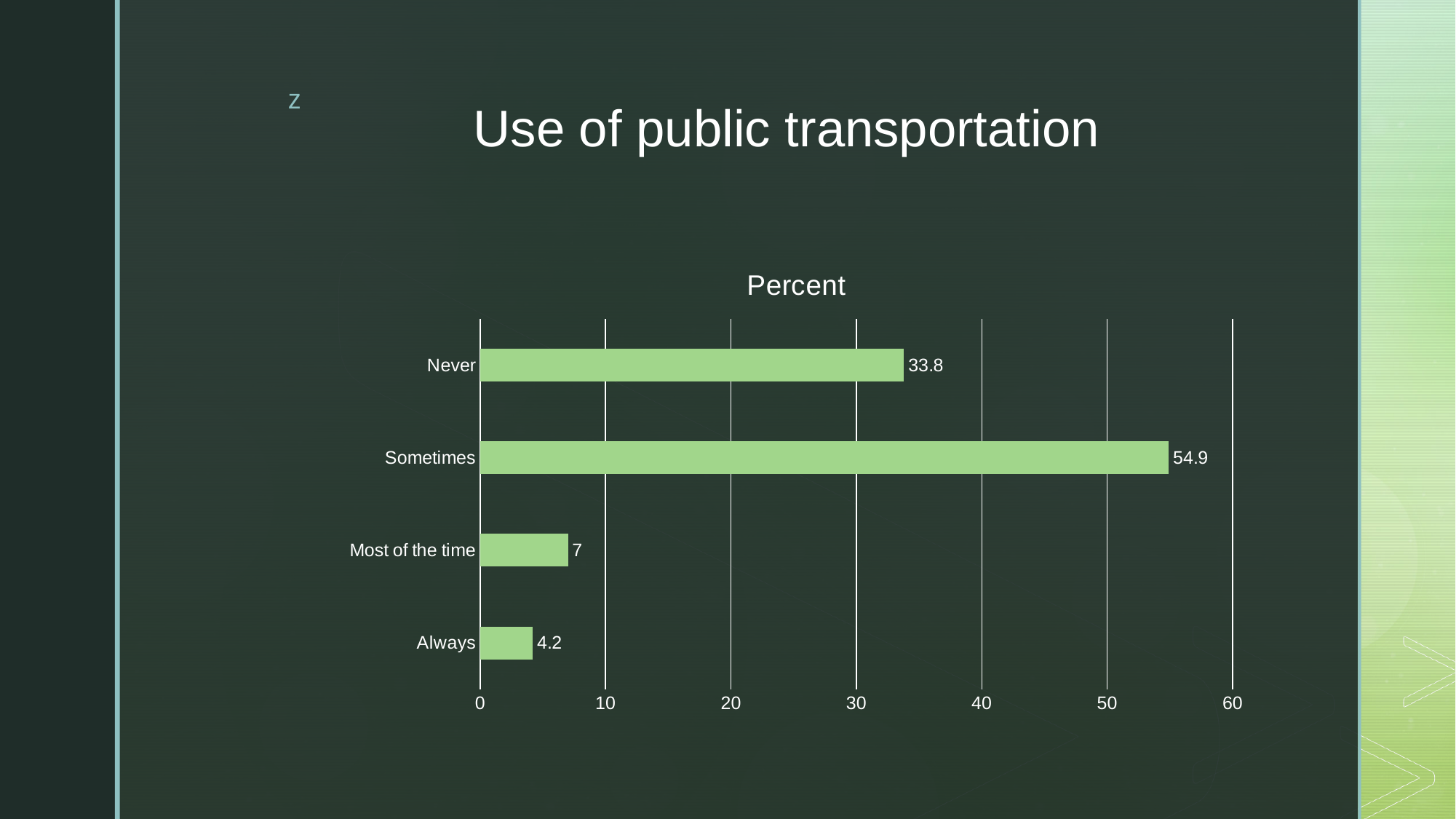
What is the value for Always? 4.2 Which category has the highest value? Sometimes What is the difference between the values for Sometimes and Never? 21.1 How many categories are shown in the chart? 4 What is the value for Sometimes? 54.9 Is the value for Never greater or less than 30? greater What kind of chart is shown on the slide? bar chart Which category has the lowest value? Always What is the value for Most of the time? 7 Which is larger, the value for Most of the time or the value for Always? Most of the time What is the title of the chart? Percent What is the value for Never? 33.8